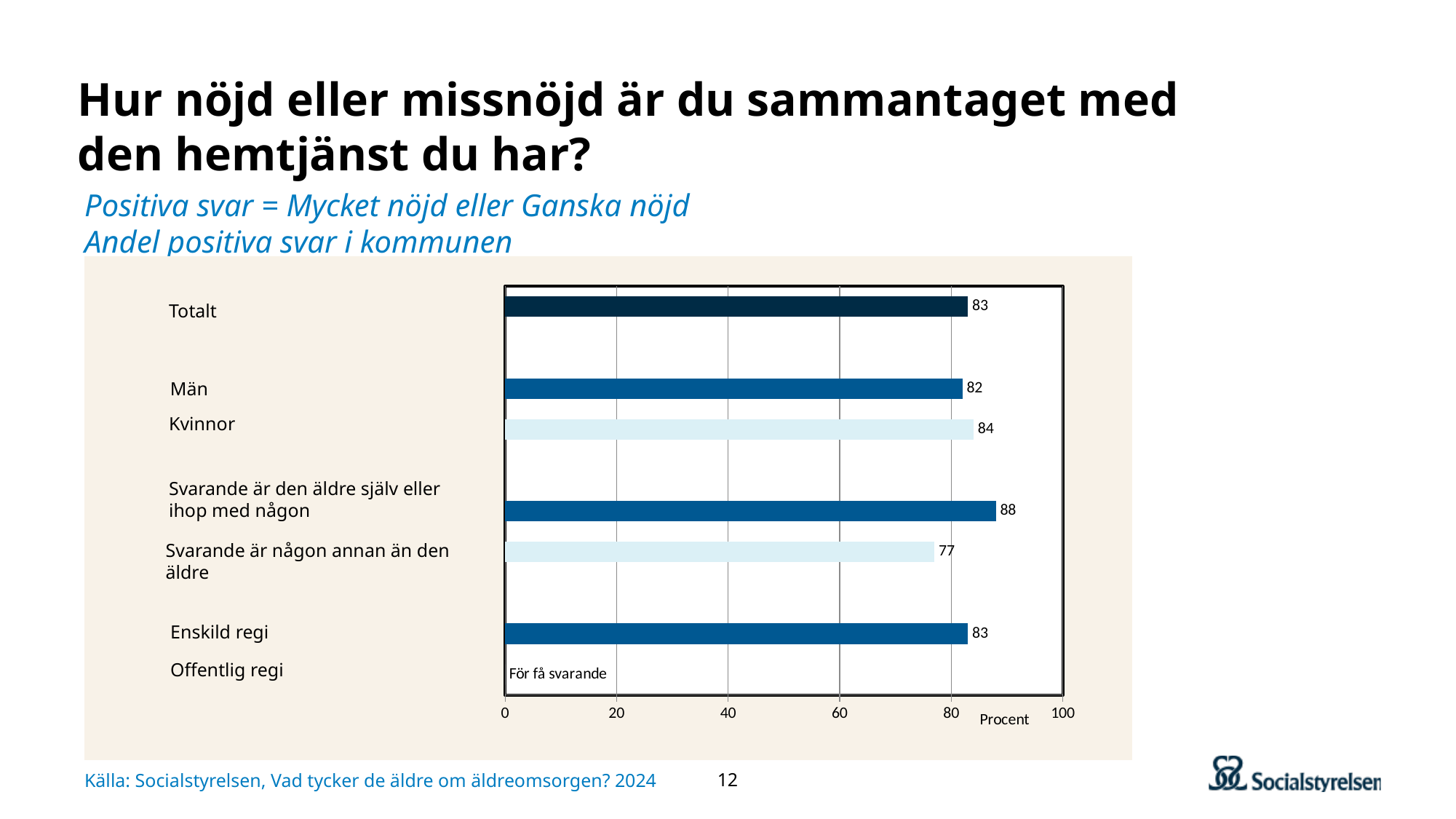
What is the label on the x axis? Procent What kind of chart is shown on the slide? Bar chart What is shown instead of a bar for Offentlig regi? För få svarande Which category has the highest value? Svarande är den äldre själv eller ihop med någon Which is larger, the value for Män or the value for Kvinnor? Kvinnor What is the value for Totalt? 83 Which category with a plotted bar has the lowest value? Svarande är någon annan än den äldre What is the value for Svarande är någon annan än den äldre? 77 What is the value for Enskild regi? 83 Is the value for Svarande är någon annan än den äldre greater or less than 80? less What is the difference between the values for Svarande är den äldre själv eller ihop med någon and Svarande är någon annan än den äldre? 11 What is the value for Kvinnor? 84